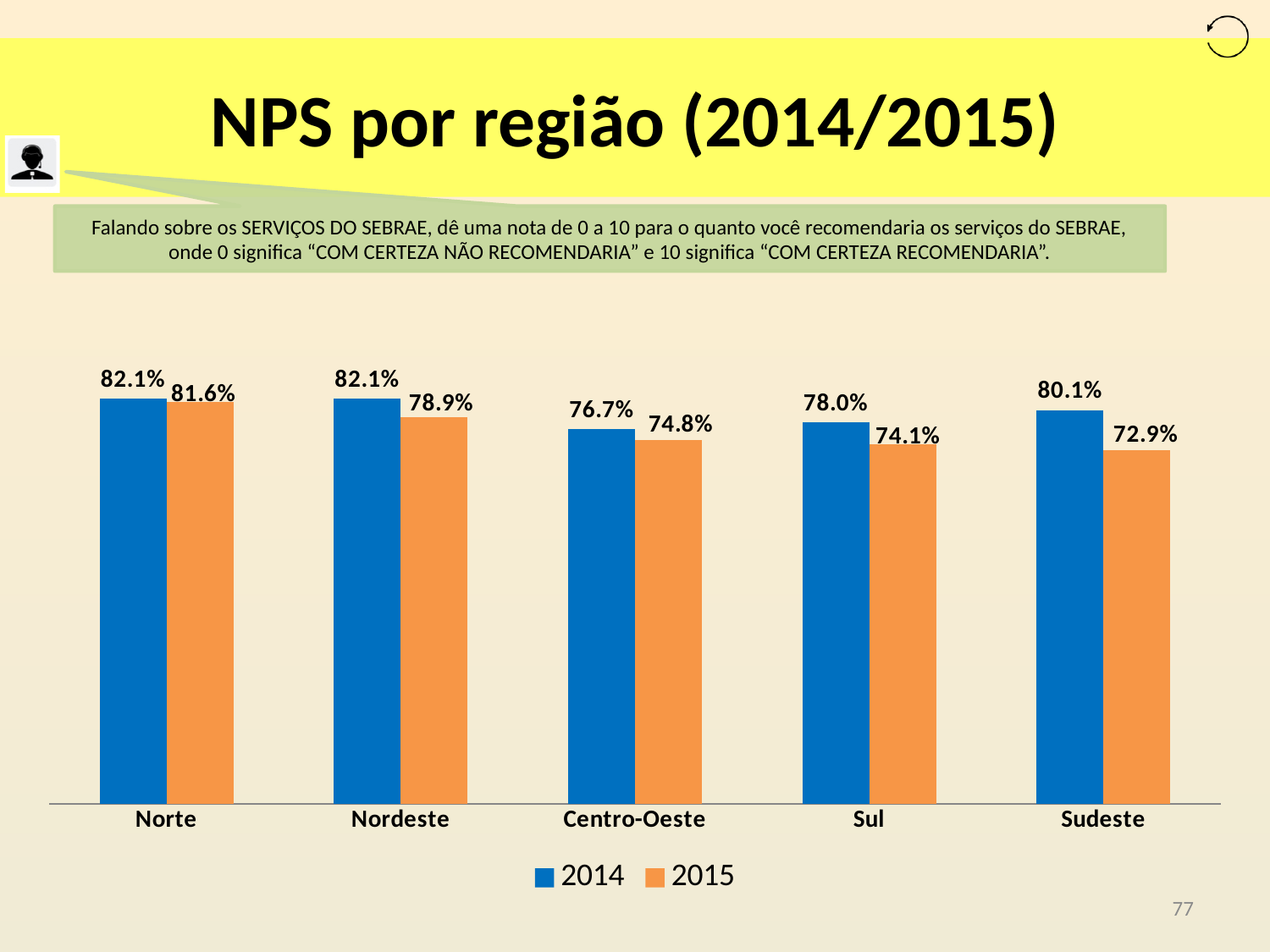
What is the 2015 value for Sudeste? 72.9% What type of chart is shown on the slide? Bar chart How many regions are shown on the x axis? 5 What is the difference between the 2014 and 2015 values for Sul? 3.9 percentage points What is the 2014 value for Sul? 78.0% What is the 2015 value for Centro-Oeste? 74.8% How many series does the legend list? 2 Which region has the highest 2015 value? Norte Which region has the lowest 2015 value? Sudeste What is the difference between the 2014 and 2015 values for Sudeste? 7.2 percentage points Which region has the lowest 2014 value? Centro-Oeste Which is larger, the 2015 value for Nordeste or the 2015 value for Sul? Nordeste